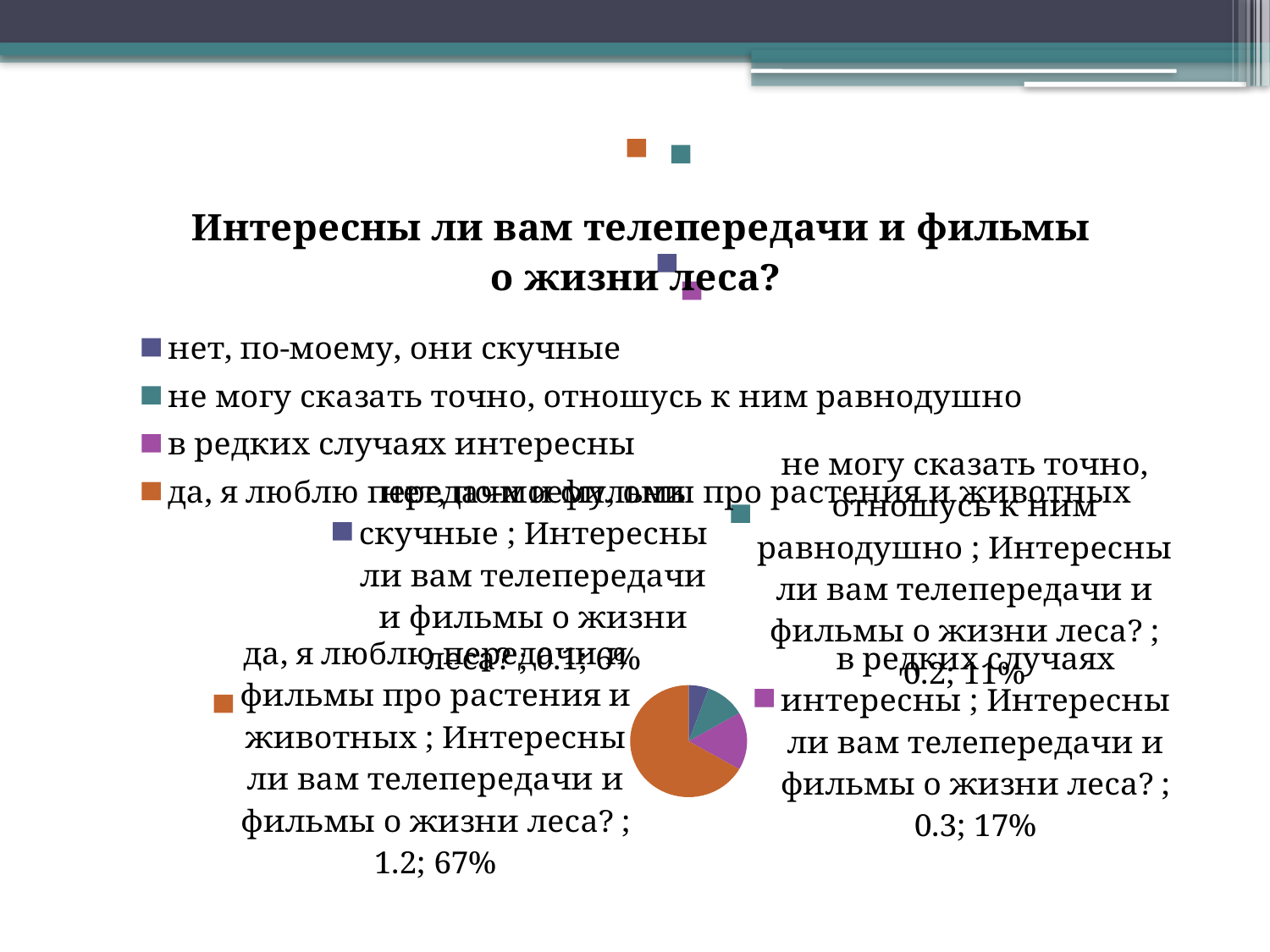
How many categories does the legend of the pie chart list? 4 What is the difference in percentage points between the "в редких случаях интересны" slice and the "не могу сказать точно, отношусь к ним равнодушно" slice? 6 What value is printed for the slice "да, я люблю передачи и фильмы про растения и животных"? 1.2 Which category has the largest slice of the pie? да, я люблю передачи и фильмы про растения и животных What is the title of the chart? Интересны ли вам телепередачи и фильмы о жизни леса? Which category has the smallest slice of the pie? нет, по-моему, они скучные What percentage share does the slice "да, я люблю передачи и фильмы про растения и животных" have? 67% What kind of chart is shown on the slide? pie chart What percentage share does the slice "не могу сказать точно, отношусь к ним равнодушно" have? 11% What value is printed for the slice "в редких случаях интересны"? 0.3 What percentage share does the slice "в редких случаях интересны" have? 17%